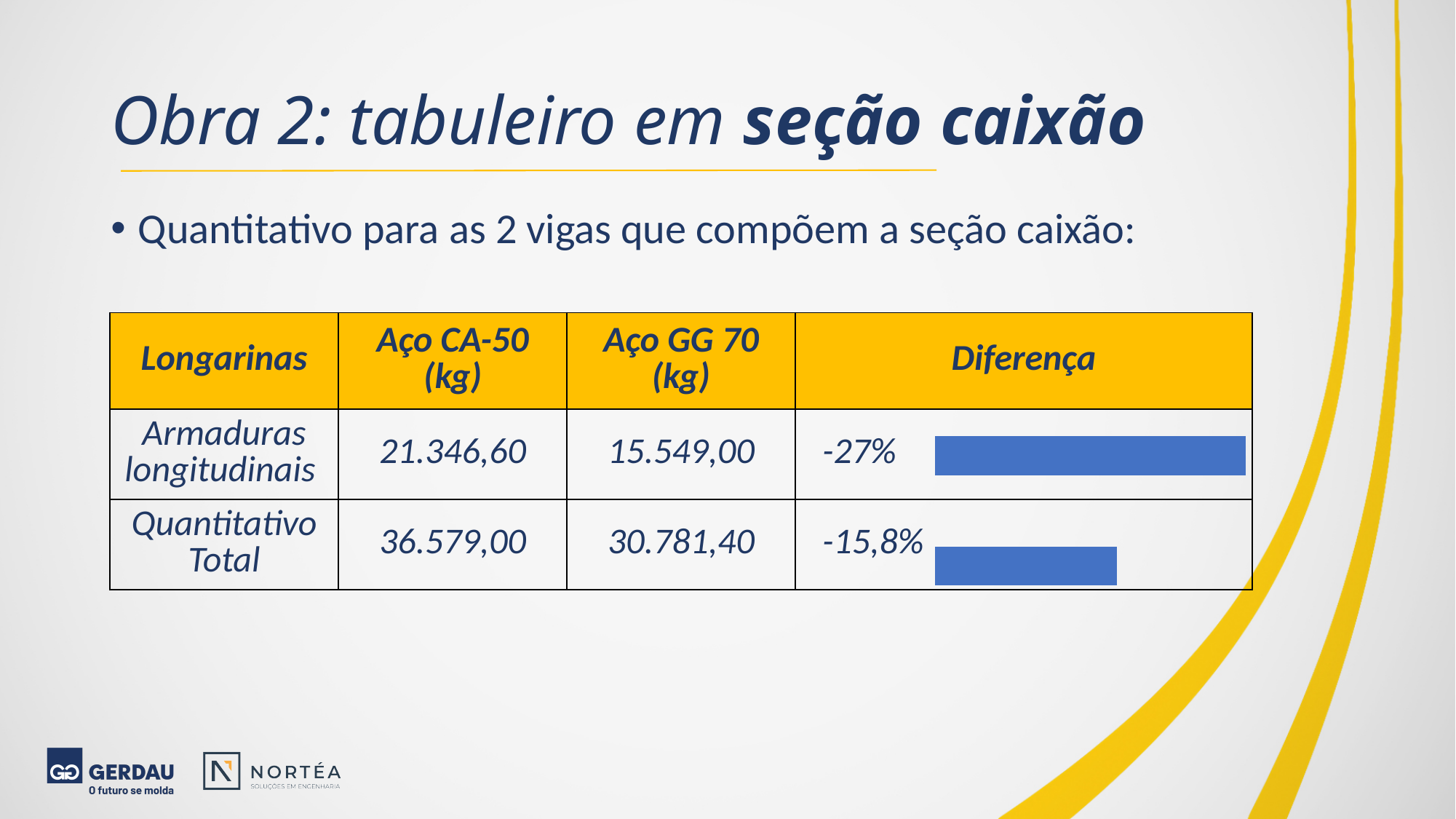
How many bars are shown in the Diferença column? 2 What is the Aço CA-50 (kg) value for Armaduras longitudinais? 21.346,60 What kind of chart is embedded in the Diferença column of the table? bar chart What is the header of the column that contains the bars? Diferença Which row has the longer bar in the Diferença column? Armaduras longitudinais What is the Diferença value shown next to the bar for Quantitativo Total? -15,8% What is the Aço GG 70 (kg) value for Quantitativo Total? 30.781,40 What is the Diferença value shown next to the bar for Armaduras longitudinais? -27% Is the bar for Armaduras longitudinais longer or shorter than the bar for Quantitativo Total? longer Which row has the shorter bar in the Diferença column? Quantitativo Total What colour are the bars in the Diferença column? blue